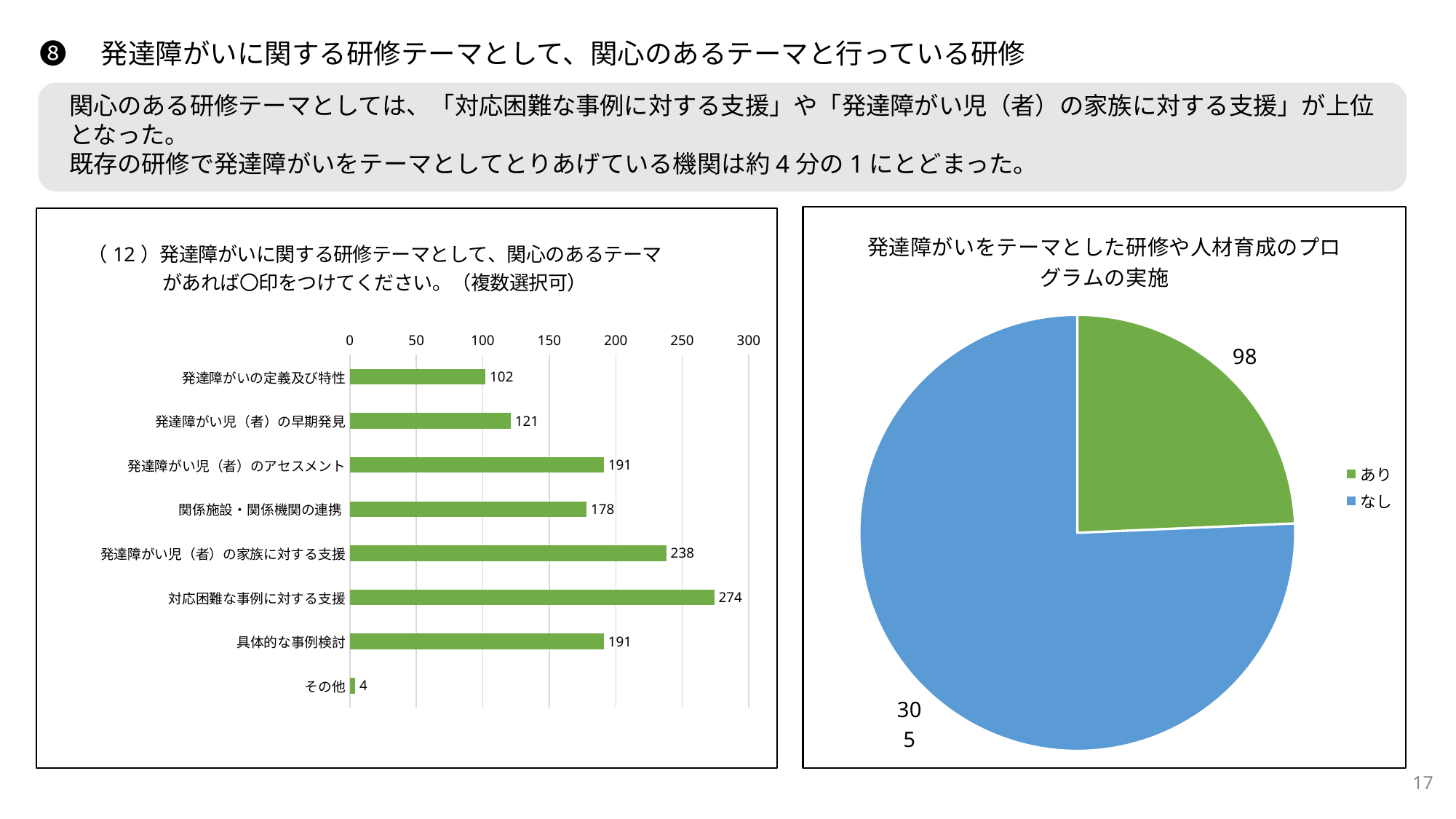
How many entries does the legend of the pie chart on the right list? 2 In the left bar chart, which is larger: 発達障がいの定義及び特性 or 発達障がい児（者）の早期発見? 発達障がい児（者）の早期発見 In the left bar chart, which category has the lowest value? その他 What type of chart is the chart on the left of the slide? Bar chart In the left bar chart, which category has the highest value? 対応困難な事例に対する支援 In the left bar chart, what is the value for 関係施設・関係機関の連携? 178 In the pie chart on the right, what is the value for なし? 305 In the left bar chart, what is the value for 発達障がい児（者）の家族に対する支援? 238 In the left bar chart, what is the difference between 対応困難な事例に対する支援 and 発達障がい児（者）の家族に対する支援? 36 In the left bar chart, what is the value for 対応困難な事例に対する支援? 274 How many categories are shown in the left bar chart? 8 In the pie chart on the right, what is the value for あり? 98